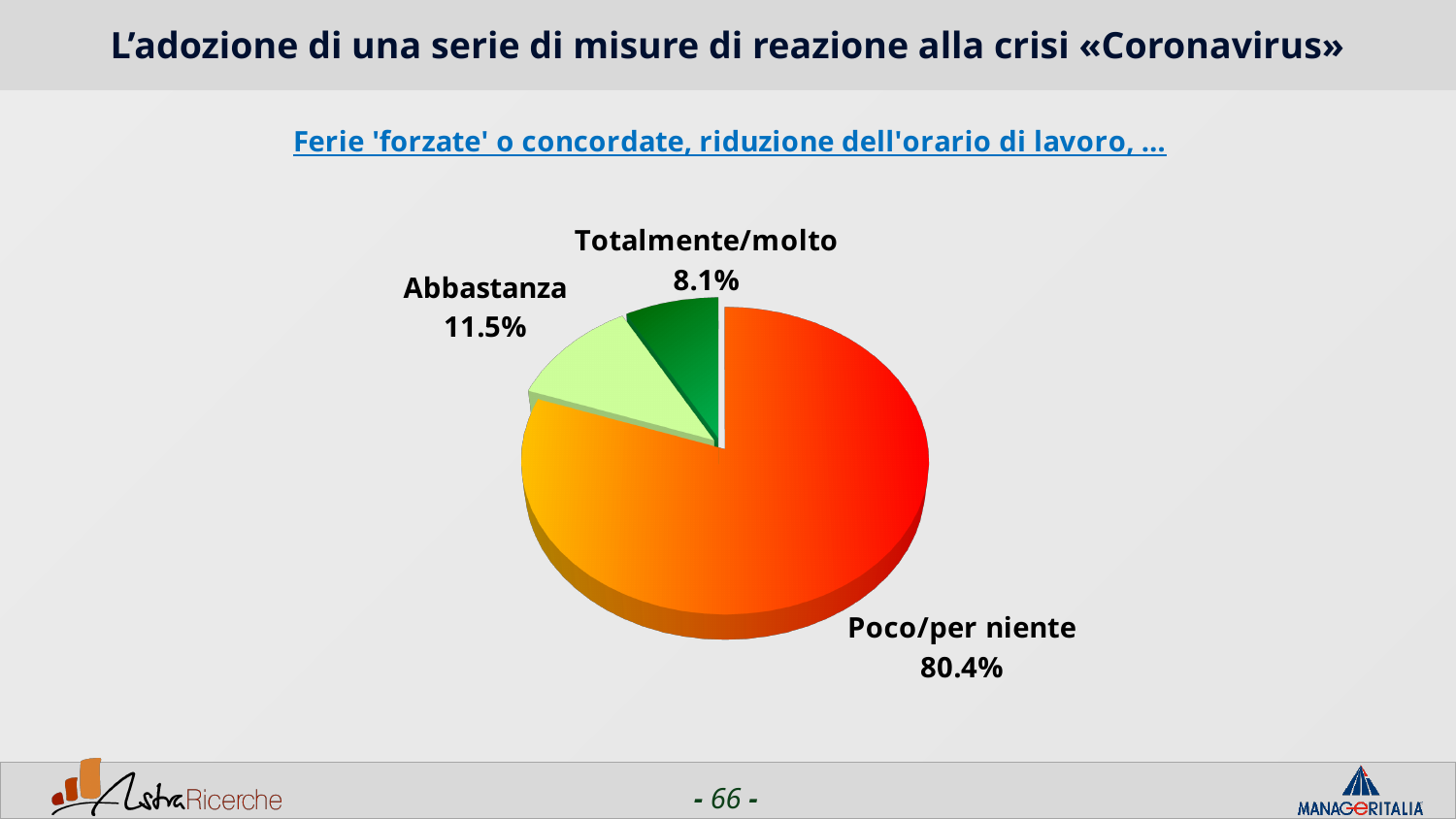
What is the subtitle above the chart? Ferie 'forzate' o concordate, riduzione dell'orario di lavoro, … Which category has the largest slice of the pie? Poco/per niente What is the difference between the 'Poco/per niente' and 'Abbastanza' values? 68.9% What is the difference between the 'Abbastanza' and 'Totalmente/molto' values? 3.4% What is the value shown for 'Totalmente/molto'? 8.1% What kind of chart is shown on the slide? Pie chart What colour is the 'Totalmente/molto' slice? Dark green Which is larger, the 'Abbastanza' slice or the 'Totalmente/molto' slice? Abbastanza How many slices does the pie chart have? 3 What share of the pie does the 'Poco/per niente' slice represent? 80.4% Which category has the smallest slice of the pie? Totalmente/molto What is the value shown for 'Abbastanza'? 11.5%